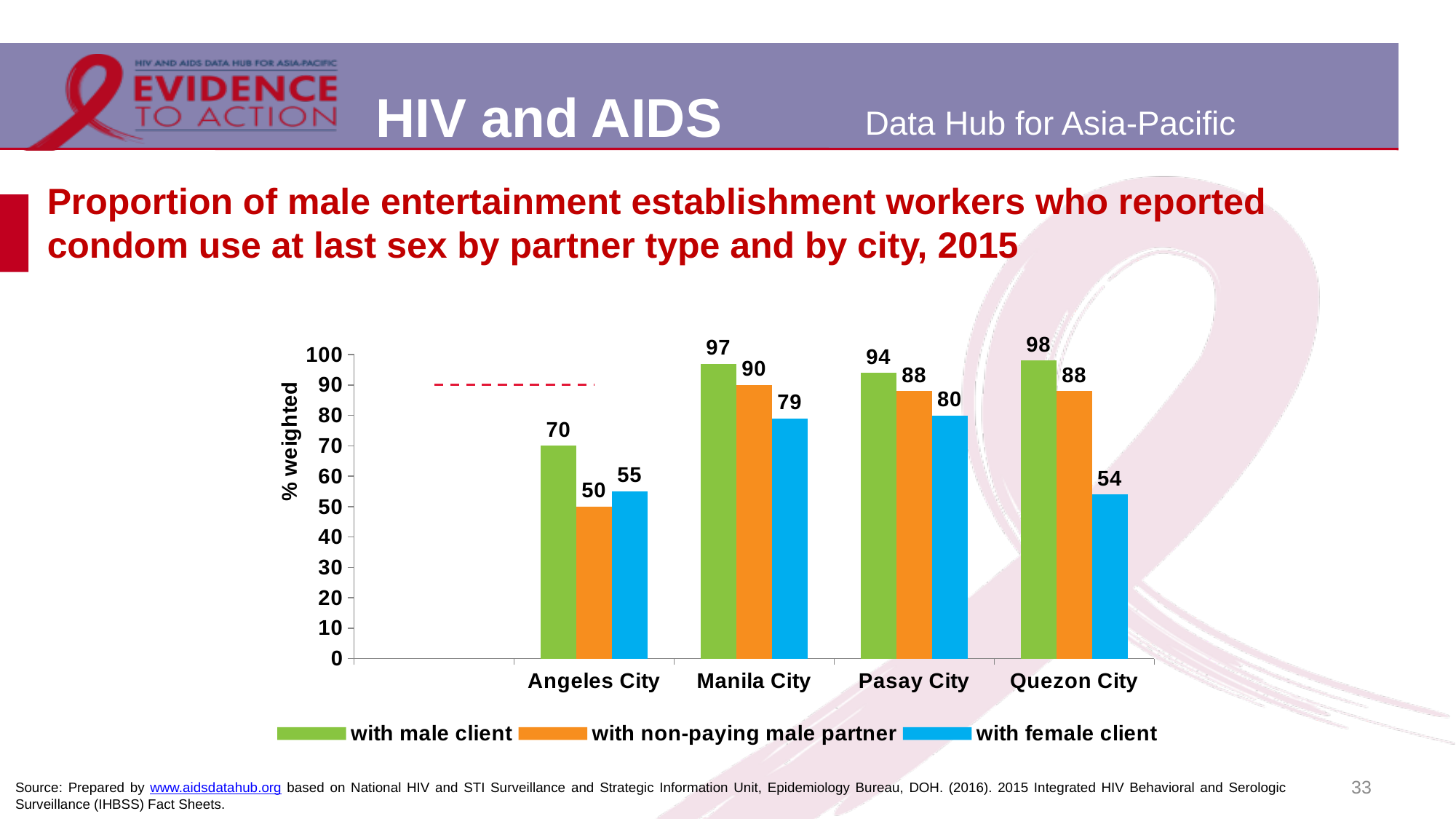
Which is larger in Pasay City: the value for 'with non-paying male partner' or 'with female client'? with non-paying male partner What kind of chart is shown on the slide? Bar chart How many cities are shown on the x axis? 4 How many series does the legend list? 3 What is the value for 'with male client' in Angeles City? 70 Which colour represents 'with female client' in the legend? Blue What is the value for 'with non-paying male partner' in Manila City? 90 What is the value for 'with female client' in Quezon City? 54 Which city has the lowest value for 'with non-paying male partner'? Angeles City What is the difference between the 'with male client' and 'with female client' values in Quezon City? 44 Which city has the highest value for 'with male client'? Quezon City What is the label of the y axis? % weighted